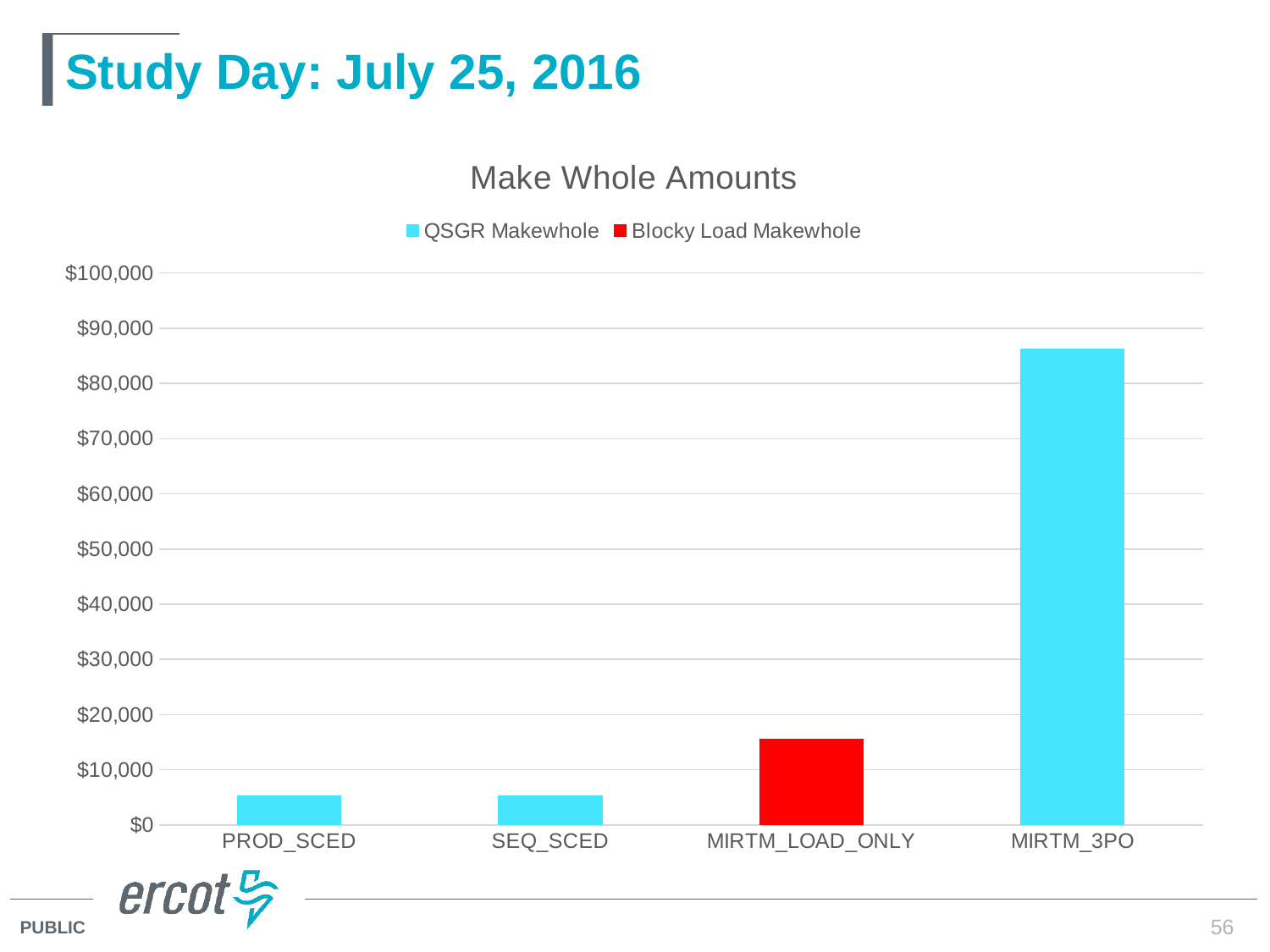
Is the value for PROD_SCED greater or less than $10,000? less What kind of chart is shown on the slide? bar chart How many series does the chart legend list? 2 Which category has the highest make whole amount? MIRTM_3PO Is the value for MIRTM_LOAD_ONLY greater or less than $20,000? less Is the value for MIRTM_3PO greater or less than $90,000? less Which series is shown in red in the chart? Blocky Load Makewhole What is the title of the chart? Make Whole Amounts Which is larger, the value for MIRTM_LOAD_ONLY or the value for SEQ_SCED? MIRTM_LOAD_ONLY How many categories are shown on the x axis of the chart? 4